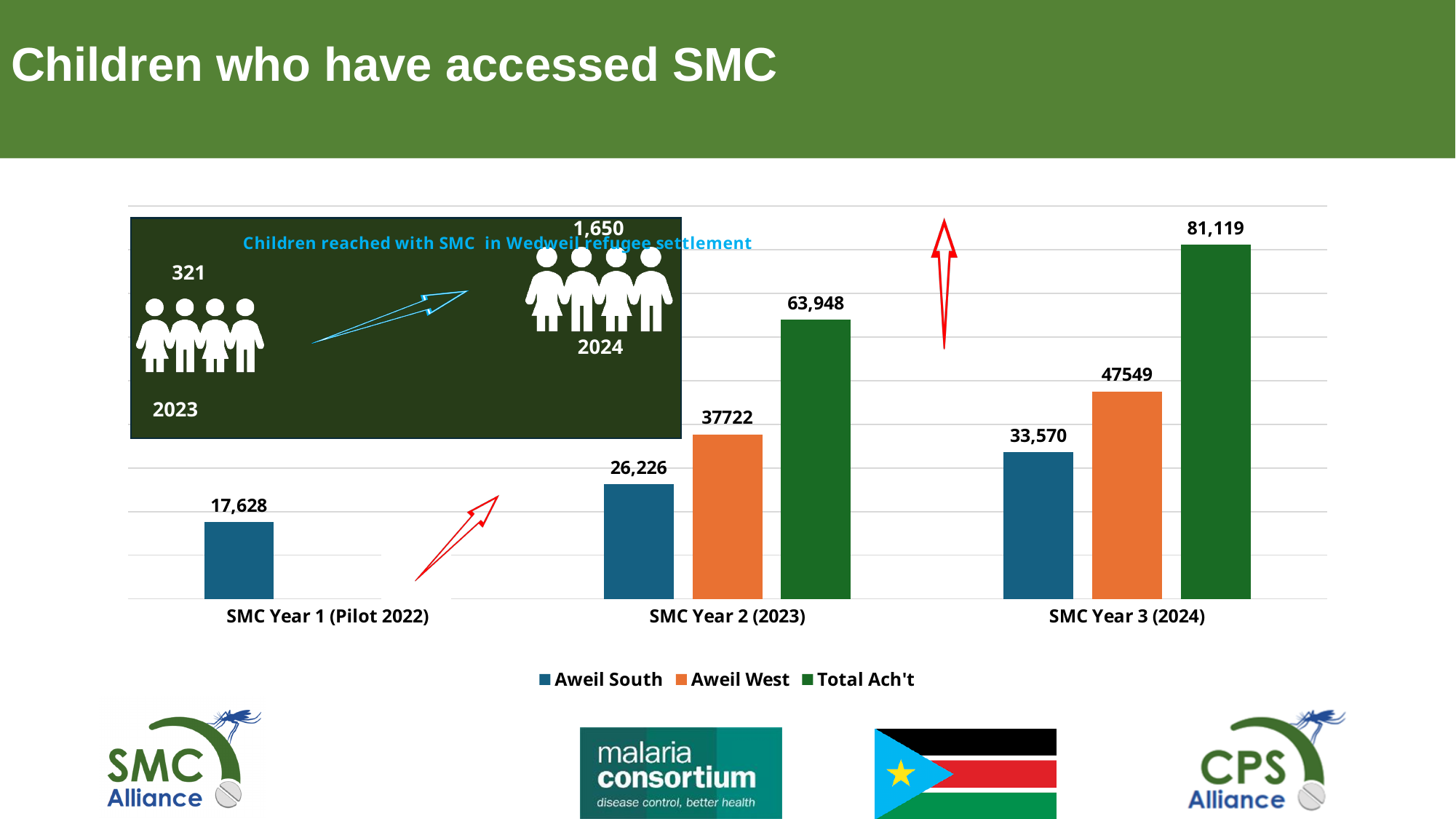
What is the difference between the Aweil West values for SMC Year 3 (2024) and SMC Year 2 (2023)? 9,827 In SMC Year 2 (2023), which is larger: Aweil South or Aweil West? Aweil West What is the Total Ach't value for SMC Year 3 (2024)? 81,119 How many series does the legend list? 3 What is the difference between the Total Ach't values for SMC Year 3 (2024) and SMC Year 2 (2023)? 17,171 What is the Aweil West value for SMC Year 2 (2023)? 37722 What is the Aweil South value for SMC Year 3 (2024)? 33,570 Which year has the highest Total Ach't value? SMC Year 3 (2024) What is the Aweil South value for SMC Year 1 (Pilot 2022)? 17,628 What kind of chart is shown on the slide? Bar chart Which year has the lowest Aweil South value? SMC Year 1 (Pilot 2022) Do the Aweil South values rise or fall from SMC Year 1 to SMC Year 3? Rise